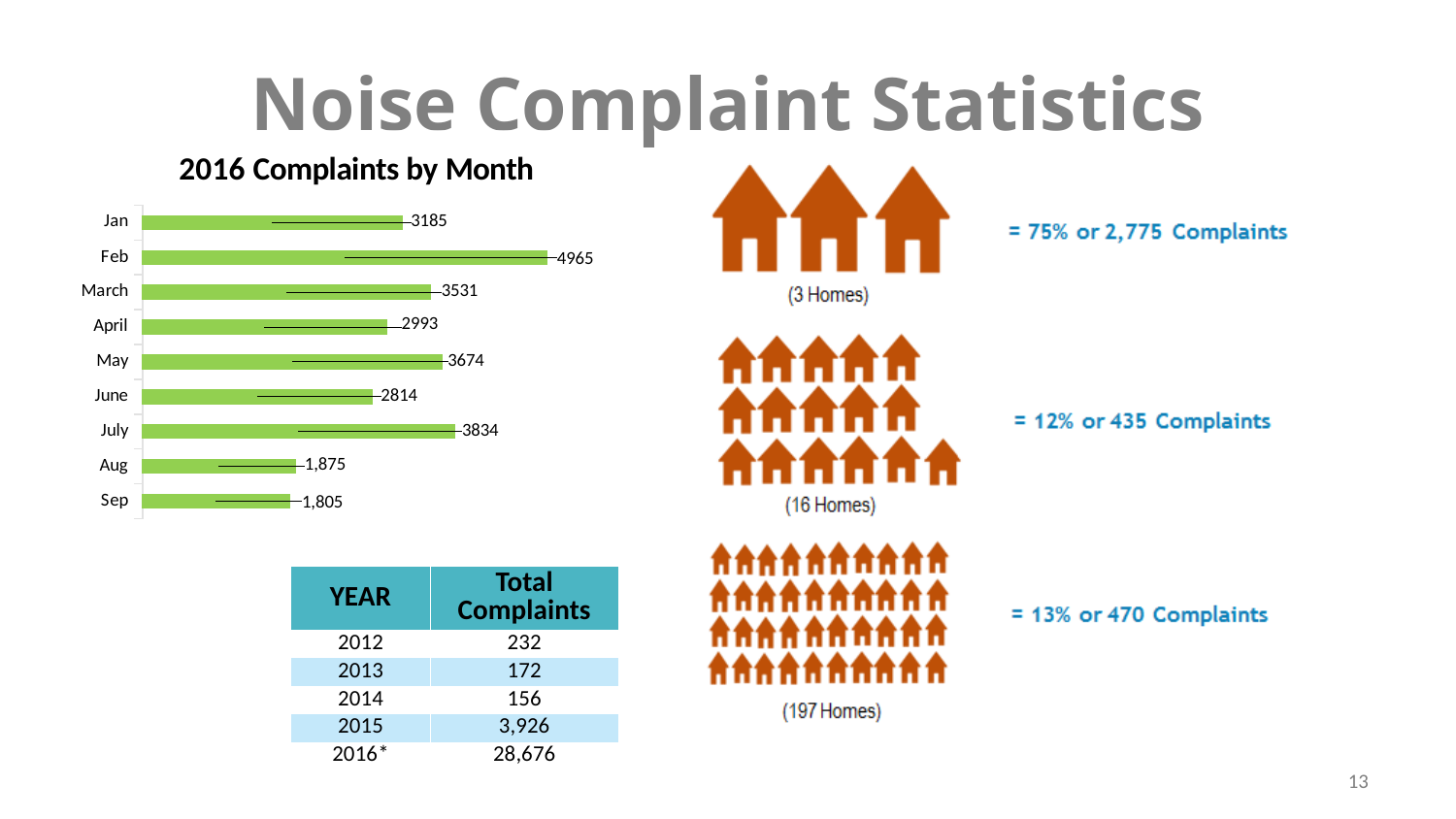
What is the value for Feb in the 2016 Complaints by Month chart? 4965 What is the difference between the values for July and June in the 2016 Complaints by Month chart? 1020 What is the value for May in the 2016 Complaints by Month chart? 3674 What is the difference between the values for Feb and Jan in the 2016 Complaints by Month chart? 1780 In the 2016 Complaints by Month chart, which is larger, the value for Jan or the value for May? May How many months are shown in the 2016 Complaints by Month chart? 9 What is the value for Aug in the 2016 Complaints by Month chart? 1,875 What is the title of the bar chart on the slide? 2016 Complaints by Month In the 2016 Complaints by Month chart, which is larger, the value for March or the value for April? March Which month has the highest value in the 2016 Complaints by Month chart? Feb Which month has the lowest value in the 2016 Complaints by Month chart? Sep What kind of chart is the 2016 Complaints by Month chart? Bar chart